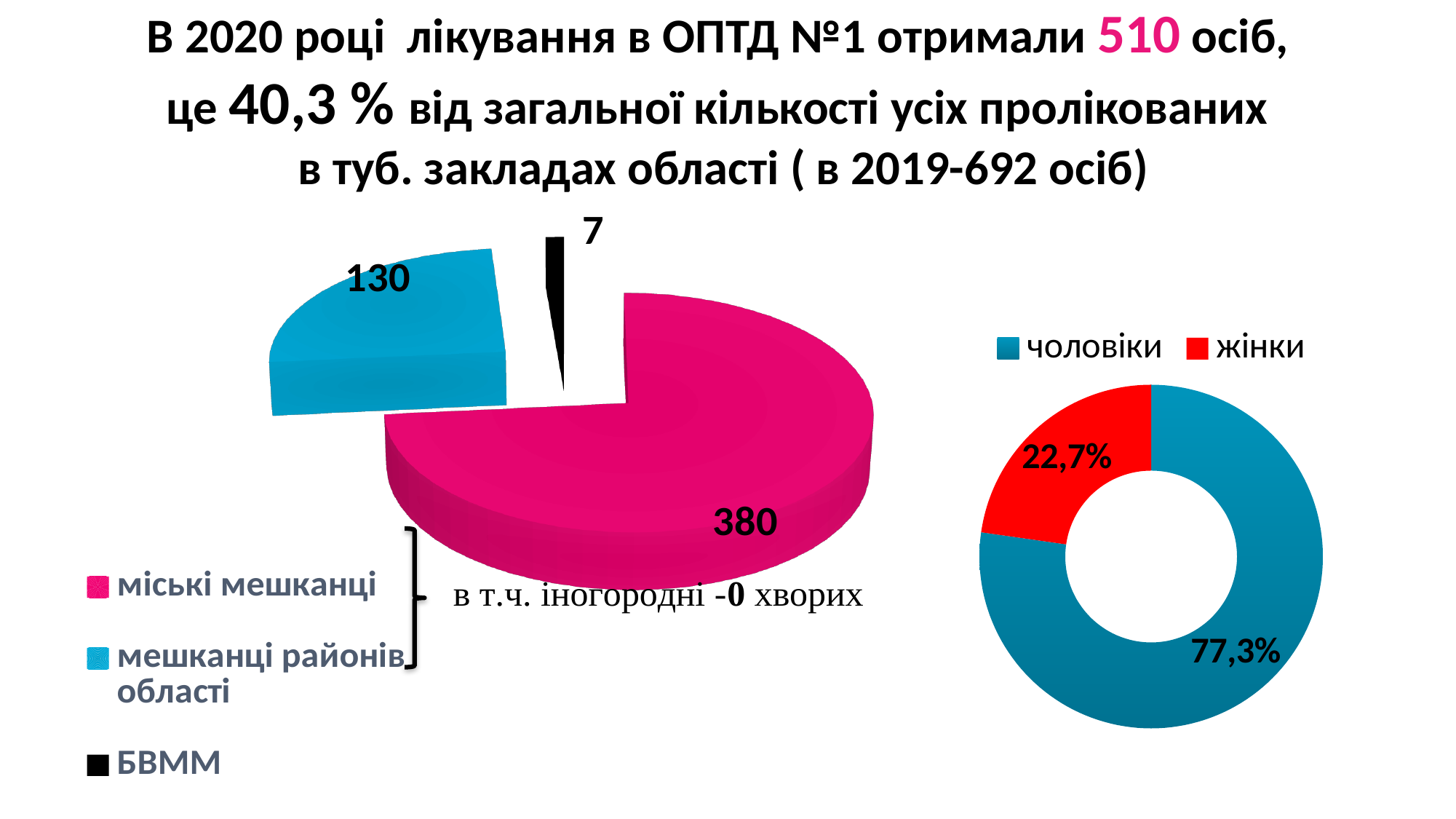
In the left pie chart, what is the value for мешканці районів області? 130 In the left pie chart, what is the value for міські мешканці? 380 In the right donut chart, which is larger, чоловіки or жінки? чоловіки What kind of chart is the chart on the left of the slide? pie chart In the right donut chart, how many entries does the legend list? 2 In the left pie chart, what is the value for БВММ? 7 In the left pie chart, which category has the largest value? міські мешканці In the left pie chart, which category has the smallest value? БВММ In the right donut chart, what is the share for чоловіки? 77,3% In the left pie chart, what is the difference between the values for міські мешканці and мешканці районів області? 250 In the right donut chart, what is the share for жінки? 22,7% In the left pie chart, how many categories are shown? 3